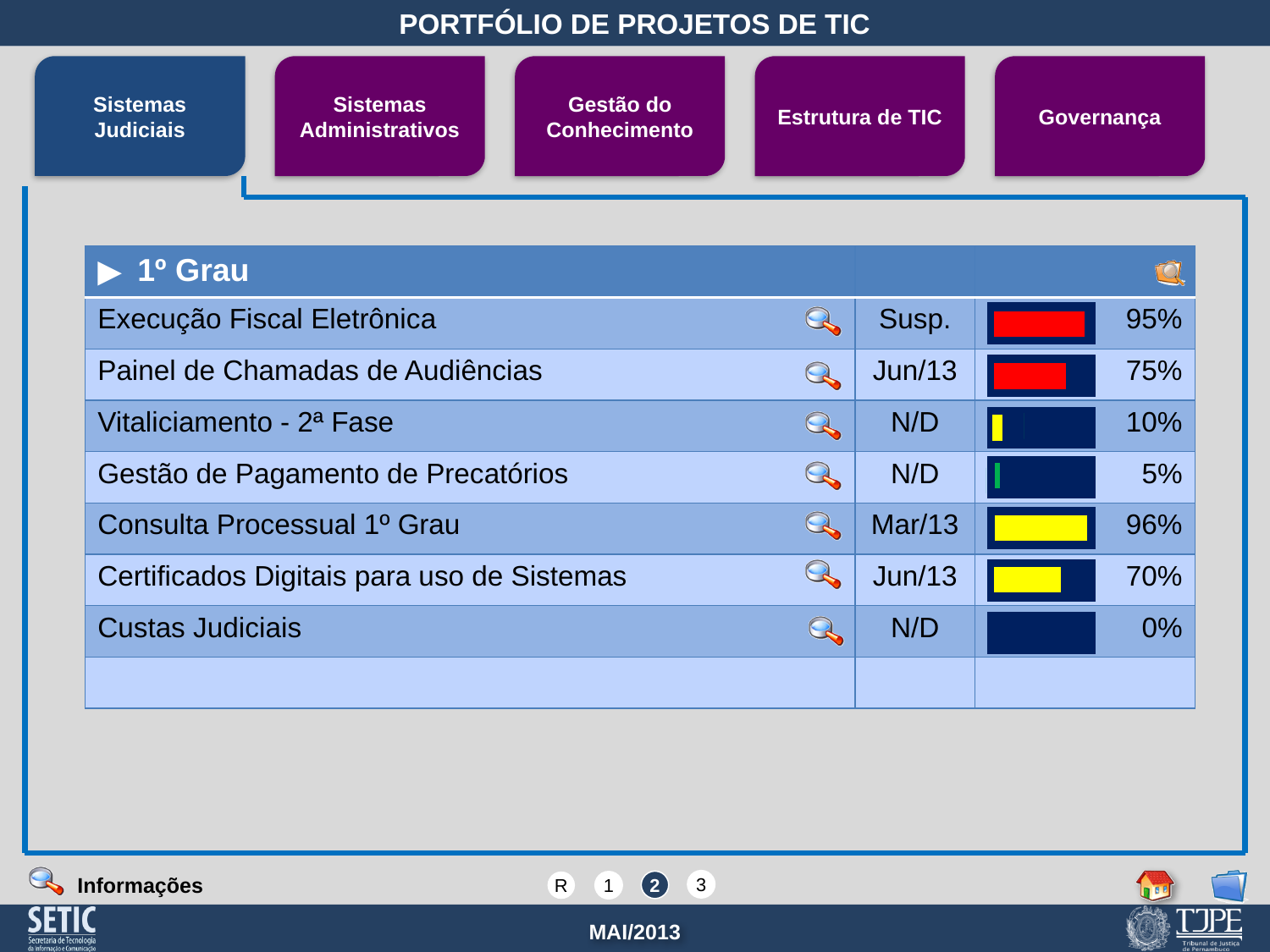
What is the completion percentage shown for Execução Fiscal Eletrônica? 95% What status or date is shown for Execução Fiscal Eletrônica? Susp. Which project in the 1º Grau table has the lowest completion percentage? Custas Judiciais Which has a higher completion percentage, Vitaliciamento - 2ª Fase or Certificados Digitais para uso de Sistemas? Certificados Digitais para uso de Sistemas How many projects are listed in the 1º Grau table? 7 What colour is the progress bar for Consulta Processual 1º Grau? Yellow What is the completion percentage shown for Gestão de Pagamento de Precatórios? 5% What kind of chart is used to show the progress of each project? Bar chart What is the difference between the completion percentages of Execução Fiscal Eletrônica and Painel de Chamadas de Audiências? 20% Which project in the 1º Grau table has the highest completion percentage? Consulta Processual 1º Grau What is the completion percentage shown for Certificados Digitais para uso de Sistemas? 70% What is the completion percentage shown for Painel de Chamadas de Audiências? 75%